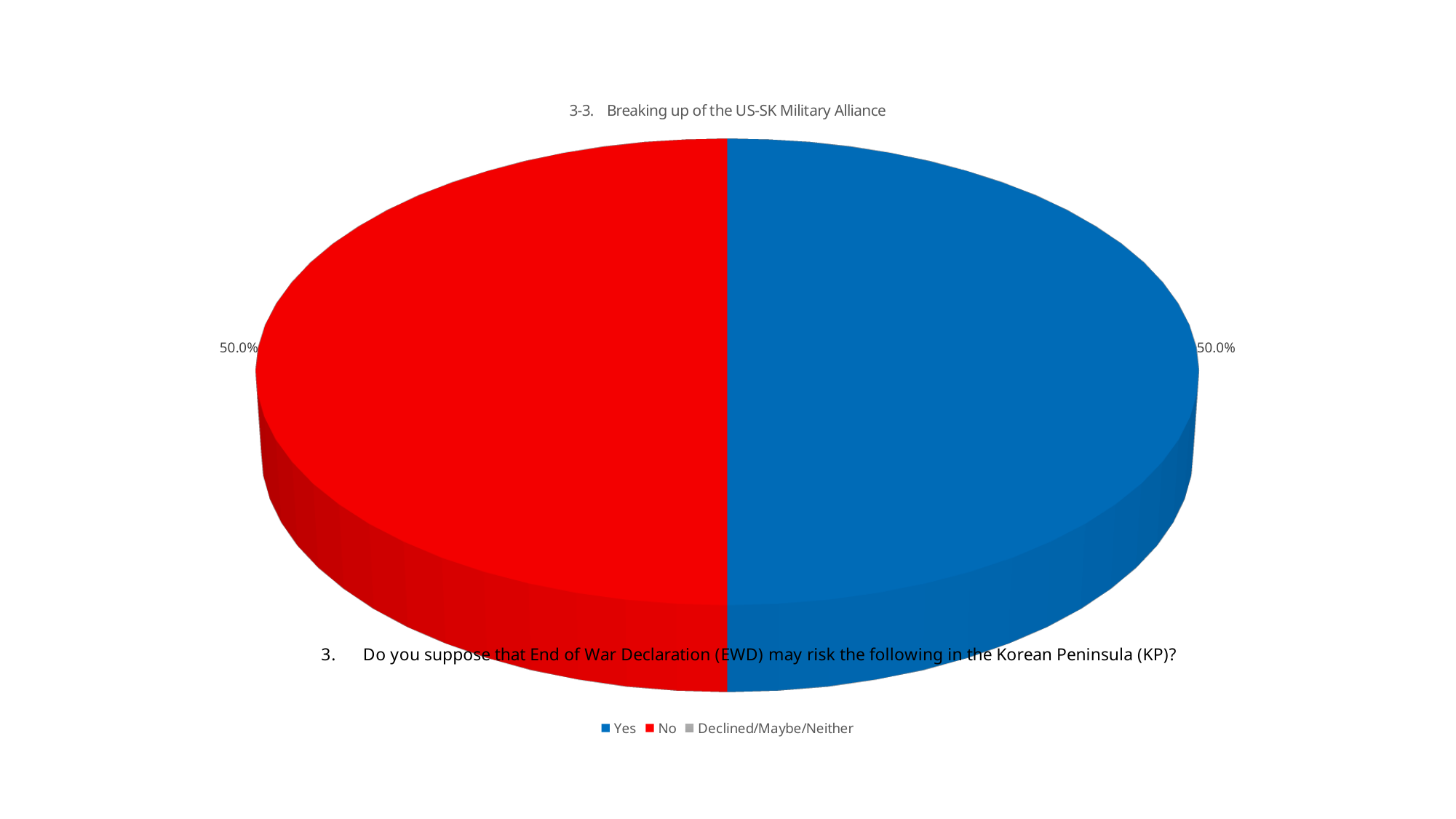
What is the title of the pie chart? 3-3. Breaking up of the US-SK Military Alliance What kind of chart is shown on the slide? Pie chart What is the combined share of the Yes and No slices in the pie chart? 100.0% Which colour represents the No category in the pie chart? Red What percentage of respondents answered No in the pie chart? 50.0% What is the difference between the Yes share and the No share in the pie chart? 0.0% How many slices are visible in the pie chart? 2 What share of the pie does the Yes slice take up? 50.0% How many entries does the legend of the pie chart list? 3 What percentage of respondents answered Yes in the pie chart? 50.0%